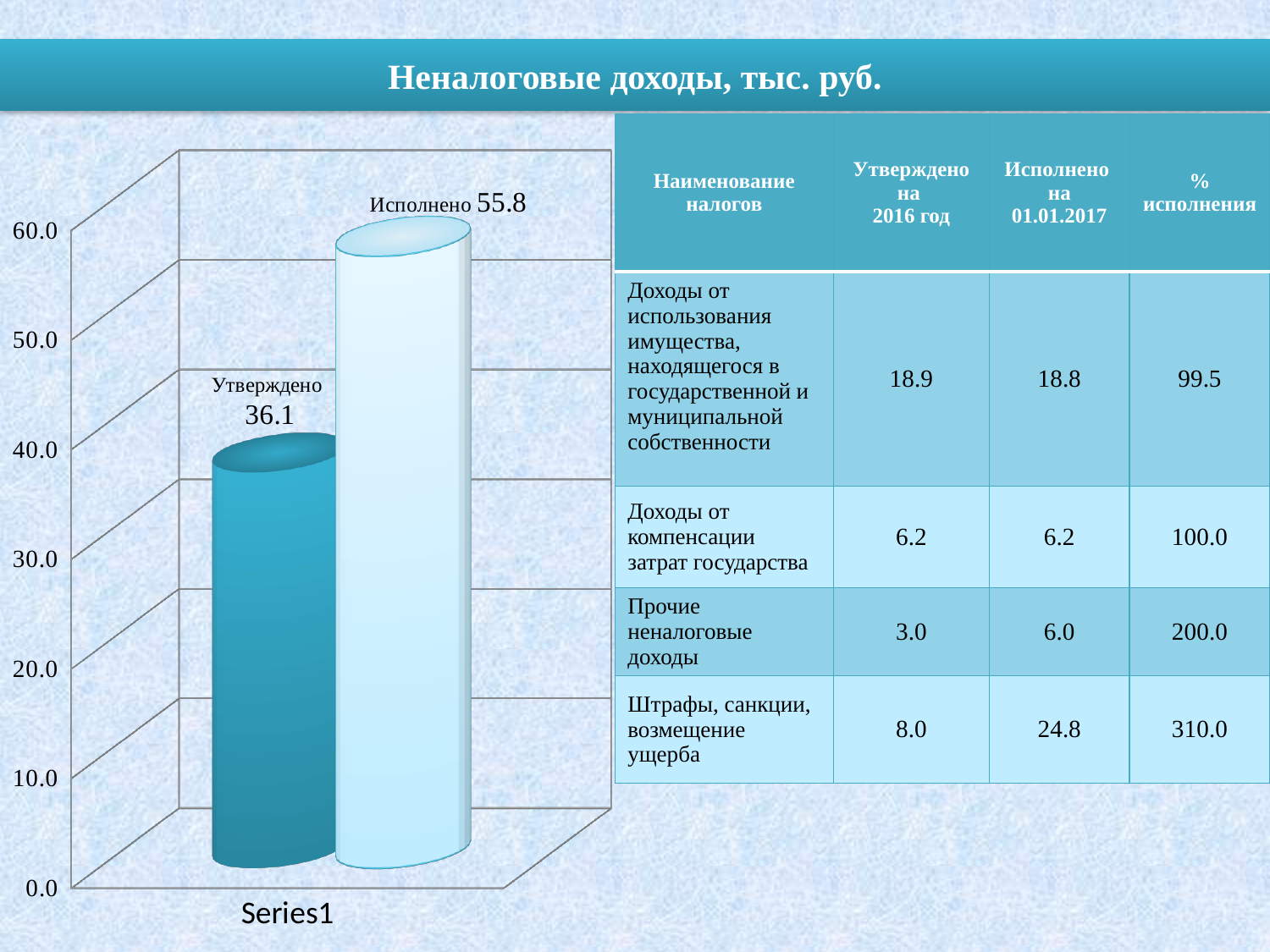
What is the value of the Исполнено bar on the chart? 55.8 Is the value of the Утверждено bar greater or less than 40.0? less What is the value of the Утверждено bar on the chart? 36.1 What is the difference between the Исполнено and Утверждено values on the chart? 19.7 Is the value of the Исполнено bar greater or less than 50.0? greater What is the maximum value shown on the vertical axis of the chart? 60.0 Which bar on the chart has the highest value? Исполнено Which bar on the chart has the lowest value? Утверждено Which bar on the chart is higher, Утверждено or Исполнено? Исполнено How many bars are plotted on the chart? 2 What kind of chart is shown on the slide? bar chart What is the label shown on the horizontal axis of the chart? Series1